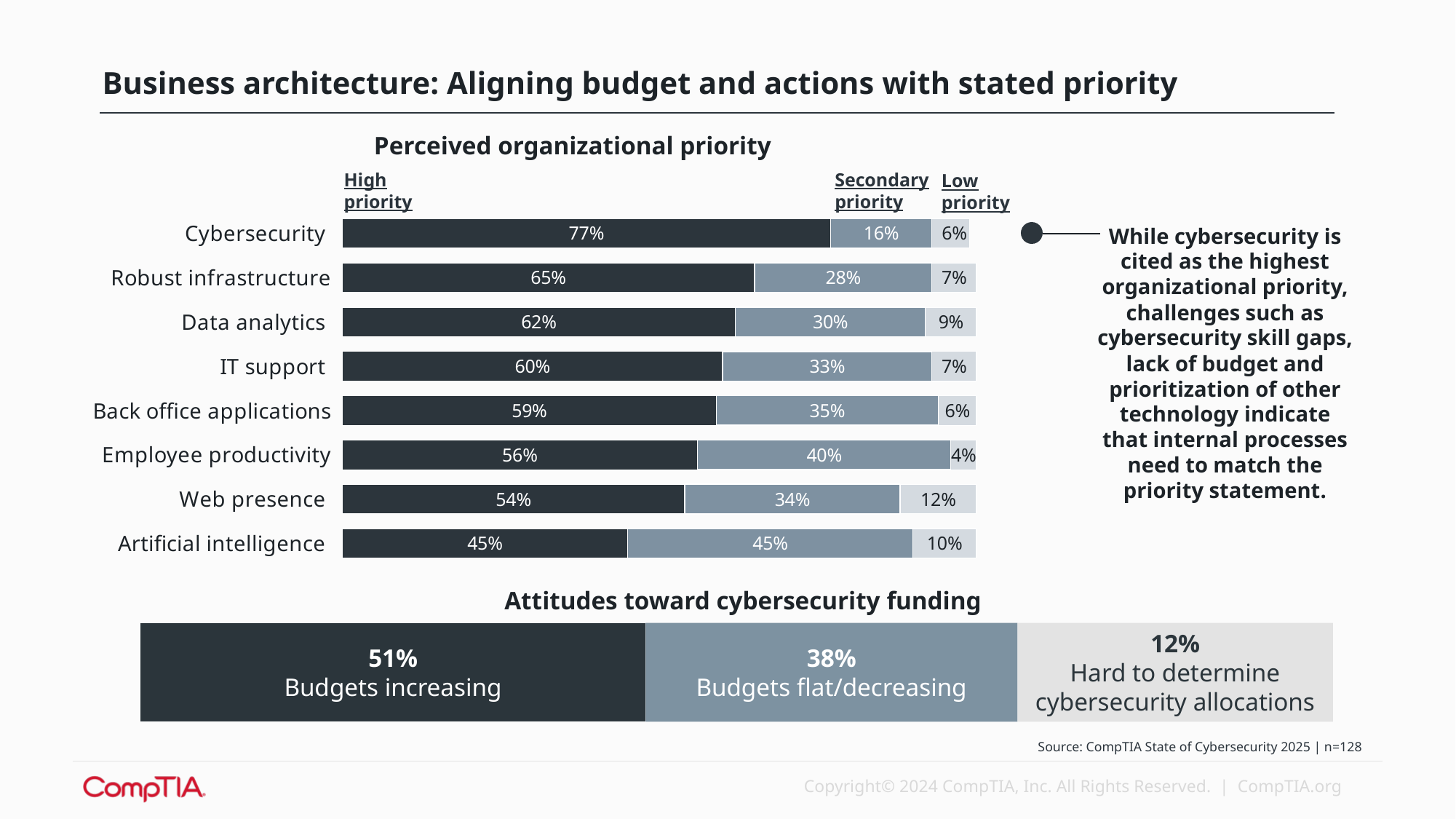
In the 'Perceived organizational priority' chart, what is the low priority value for Web presence? 12% In the 'Perceived organizational priority' chart, what percentage rate cybersecurity as a high priority? 77% In the 'Perceived organizational priority' chart, what is the difference between the high priority values for Cybersecurity and Robust infrastructure? 12 percentage points How many categories are shown in the 'Perceived organizational priority' chart? 8 In the 'Attitudes toward cybersecurity funding' chart, what is the difference between 'Budgets increasing' and 'Budgets flat/decreasing'? 13 percentage points In the 'Perceived organizational priority' chart, which has a larger secondary priority value, Employee productivity or IT support? Employee productivity What kind of chart is the 'Perceived organizational priority' chart? Stacked bar chart In the 'Perceived organizational priority' chart, what is the secondary priority value for Artificial intelligence? 45% In the 'Perceived organizational priority' chart, which category has the highest high priority value? Cybersecurity How many series does the 'Perceived organizational priority' chart show? 3 In the 'Attitudes toward cybersecurity funding' chart, what percentage report budgets increasing? 51% In the 'Perceived organizational priority' chart, which category has the lowest high priority value? Artificial intelligence